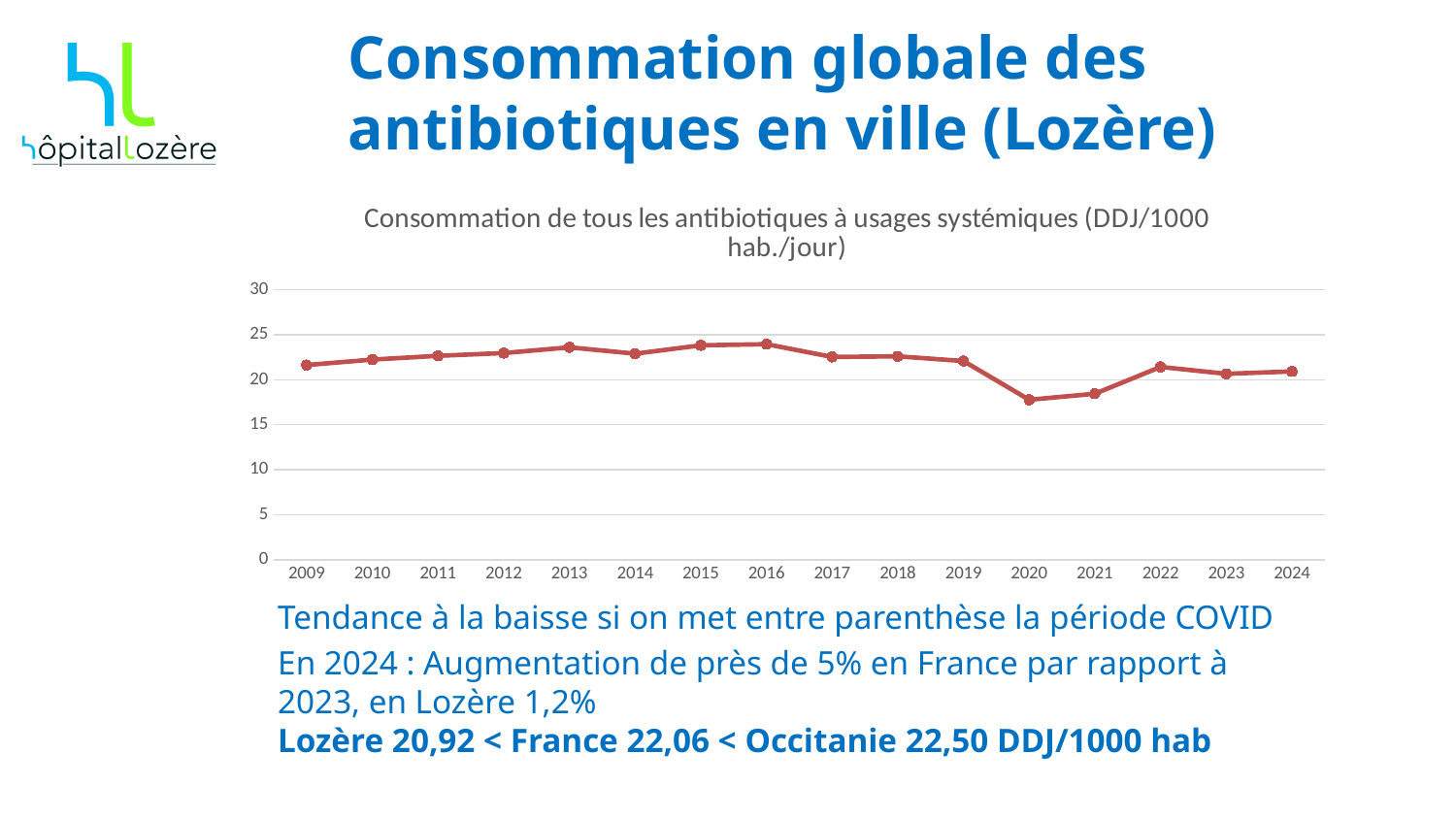
What is the title of the chart? Consommation de tous les antibiotiques à usages systémiques (DDJ/1000 hab./jour) Is the value for 2021 greater or less than 20? less Is the value for 2016 greater or less than 20? greater What kind of chart is shown on the slide? line chart Which year has the larger value, 2013 or 2022? 2013 Which year has the lowest antibiotic consumption value in the chart? 2020 Is the value for 2016 greater or less than 25? less How many years are plotted along the x axis of the chart? 16 Which year has the larger value, 2016 or 2020? 2016 Do the values rise or fall between 2016 and 2020? fall